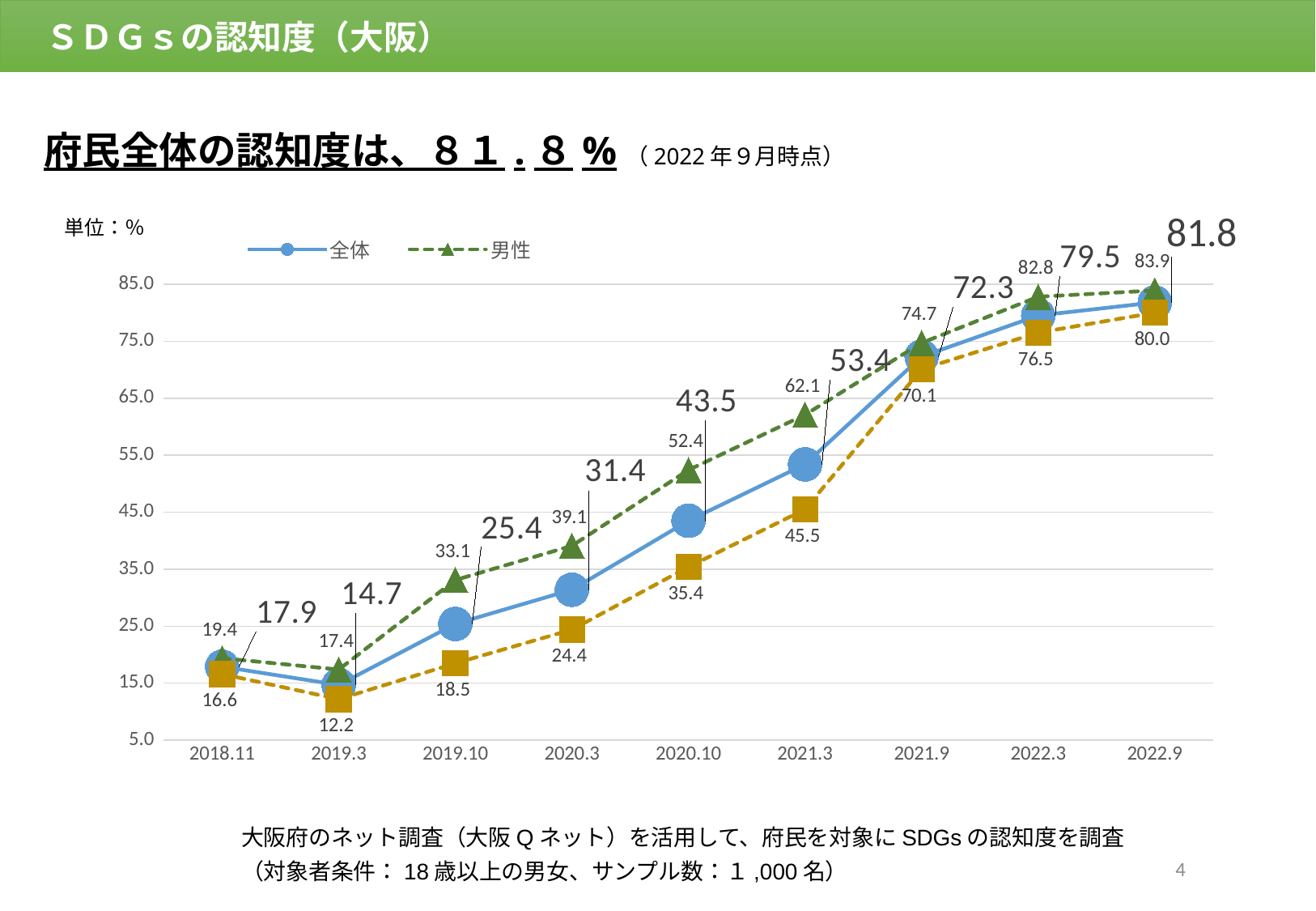
What is the value for 全体 at 2019.10? 25.4 What is the difference between the 男性 and 全体 values at 2020.10? 8.9 At which date is the 全体 value highest? 2022.9 What is the value for 全体 at 2022.9? 81.8 What is the value for 男性 at 2021.3? 62.1 At which date is the 全体 value lowest? 2019.3 At 2021.9, which is larger: the 全体 value or the 男性 value? 男性 Is the value for 全体 at 2021.3 greater or less than 55.0? less Does the 全体 value rise or fall from 2019.3 to 2022.9? rise How many series does the legend list? 2 What kind of chart is shown on the slide? line chart How many dates are plotted on the x axis? 9